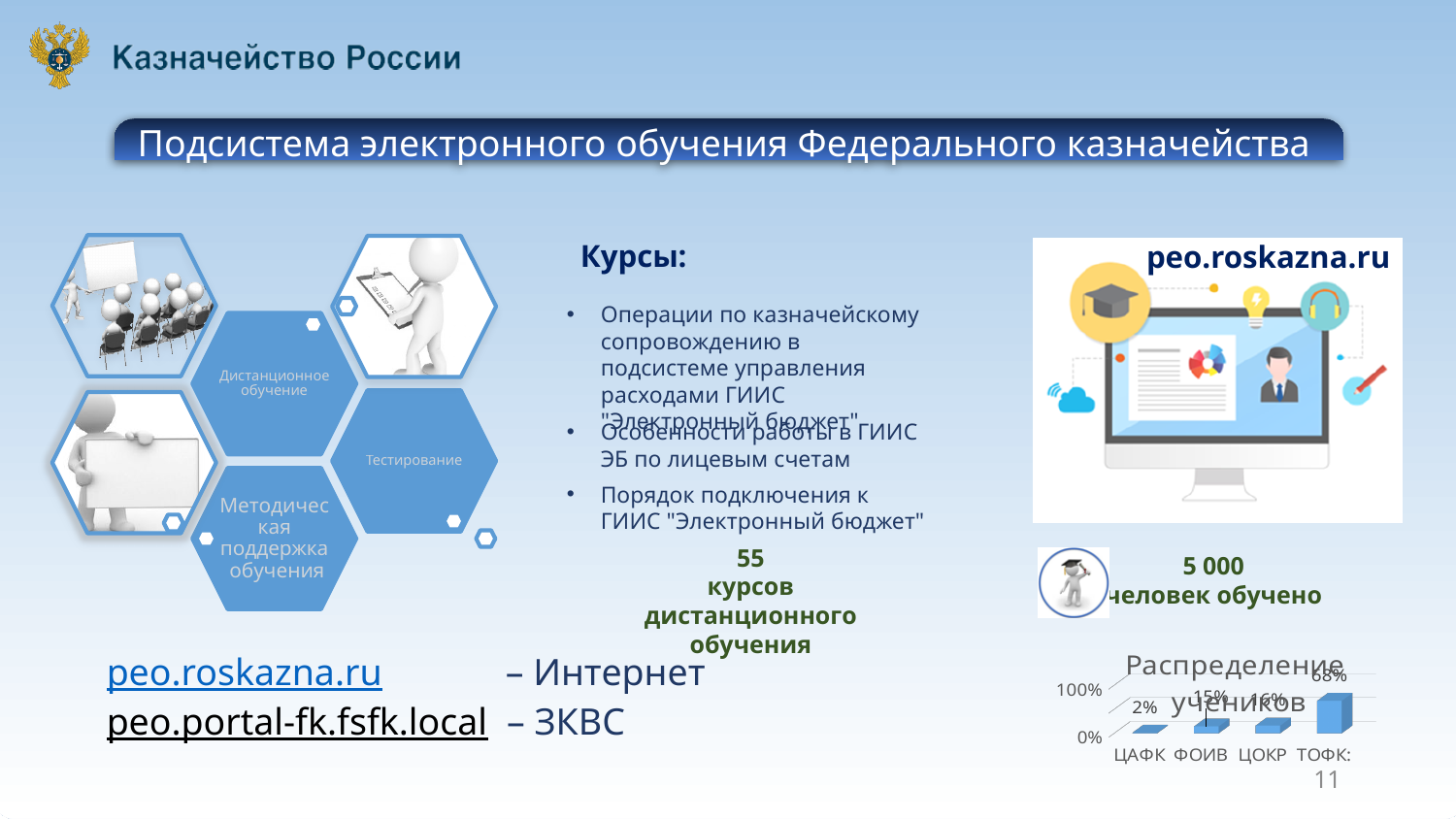
In the "Распределение учеников" chart, what is the value for ЦОКР? 16% In the "Распределение учеников" chart, what is the value for ФОИВ? 15% In the "Распределение учеников" chart, what is the value for ТОФК? 68% In the "Распределение учеников" chart, how many categories are shown on the x axis? 4 What kind of chart is shown under the title "Распределение учеников"? bar chart In the "Распределение учеников" chart, which is larger: the value for ФОИВ or the value for ЦАФК? ФОИВ In the "Распределение учеников" chart, is the value for ТОФК greater or less than 100%? less In the "Распределение учеников" chart, which category has the lowest value? ЦАФК In the "Распределение учеников" chart, what is the value for ЦАФК? 2% In the "Распределение учеников" chart, which category has the highest value? ТОФК What is the title of the chart at the bottom right of the slide? Распределение учеников In the "Распределение учеников" chart, what is the difference between the values for ТОФК and ЦОКР? 52%